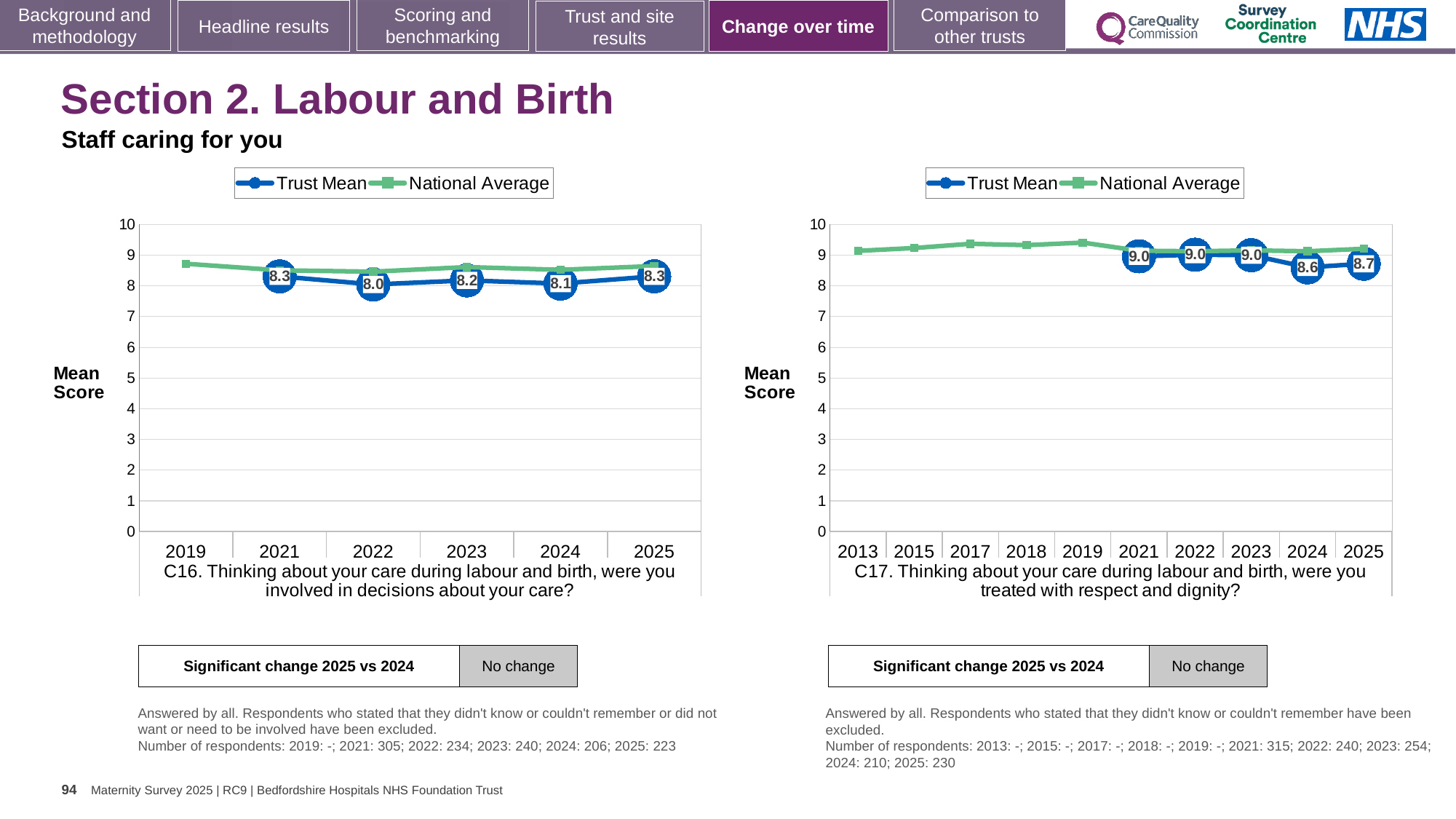
In the C16 chart (left), what is the Trust Mean for 2022? 8.0 In the C16 chart (left), how many years are shown on the x axis? 6 In the C17 chart (right), which year has the lowest labelled Trust Mean? 2024 In the C17 chart (right), is the National Average for 2019 greater or less than 9? greater In the C16 chart (left), which year has the lowest labelled Trust Mean? 2022 In the C16 chart (left), what is the difference between the Trust Mean for 2021 and 2022? 0.3 In the C17 chart (right), what is the Trust Mean for 2024? 8.6 In the C16 chart (left), what is the Trust Mean for 2025? 8.3 In the C17 chart (right), is the Trust Mean for 2024 greater or less than the Trust Mean for 2025? less In the C17 chart (right), what is the Trust Mean for 2025? 8.7 In the C17 chart (right), how many years are shown on the x axis? 10 What type of chart is used for C16 on the left? Line chart